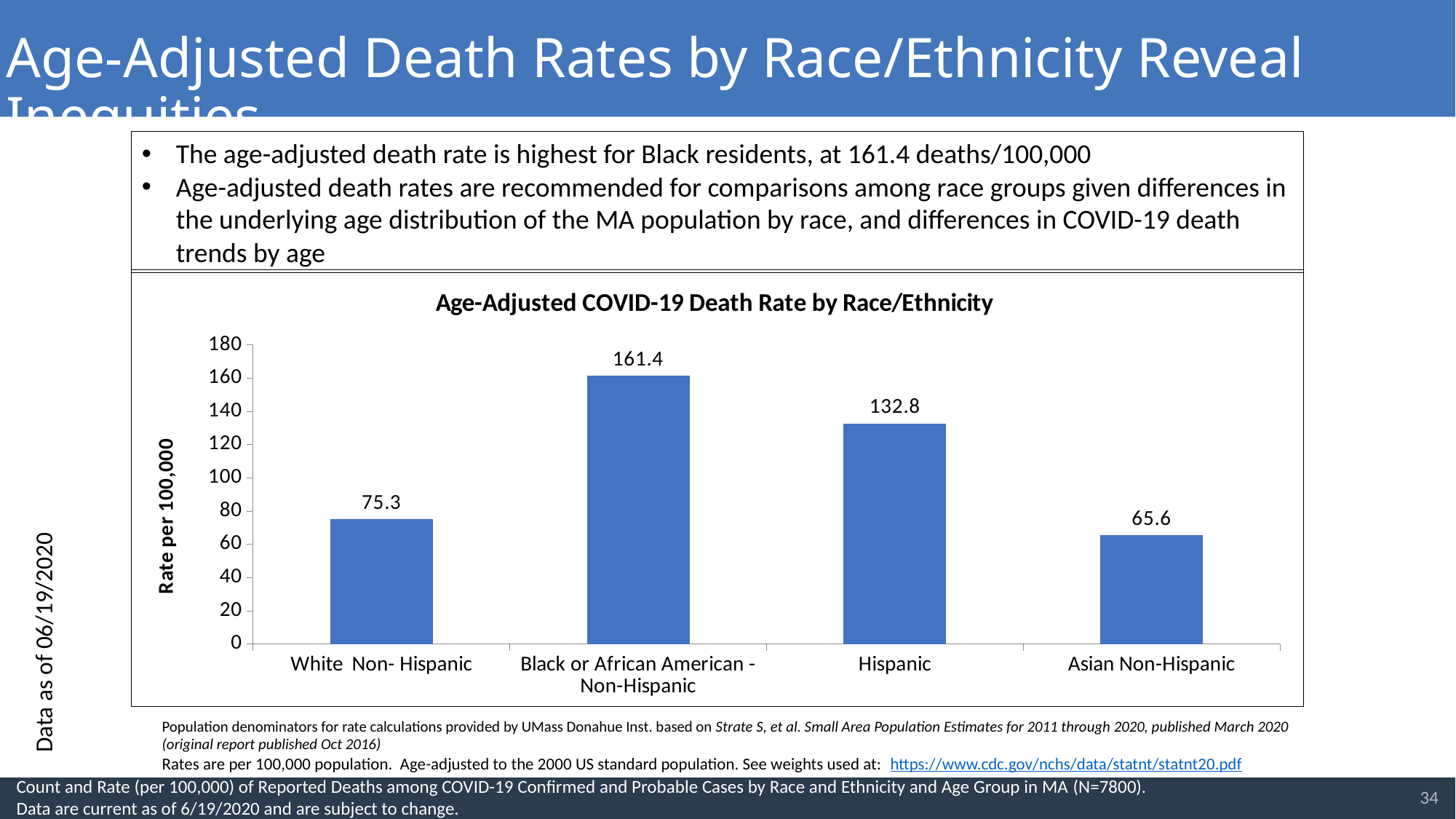
Is the death rate for Hispanic residents greater or less than 120? greater What is the difference between the death rates for White Non-Hispanic and Asian Non-Hispanic residents? 9.7 How many race/ethnicity categories are shown in the chart? 4 What is the age-adjusted COVID-19 death rate for White Non-Hispanic residents? 75.3 What is the age-adjusted COVID-19 death rate for Black or African American - Non-Hispanic residents? 161.4 Which race/ethnicity group has the lowest age-adjusted death rate? Asian Non-Hispanic What is the age-adjusted COVID-19 death rate for Asian Non-Hispanic residents? 65.6 Which group has a higher age-adjusted death rate, Hispanic or White Non-Hispanic? Hispanic What type of chart is used to show the age-adjusted COVID-19 death rates? Bar chart What is the difference between the death rates for Black or African American - Non-Hispanic and Hispanic residents? 28.6 What is the age-adjusted COVID-19 death rate for Hispanic residents? 132.8 Which race/ethnicity group has the highest age-adjusted death rate? Black or African American - Non-Hispanic